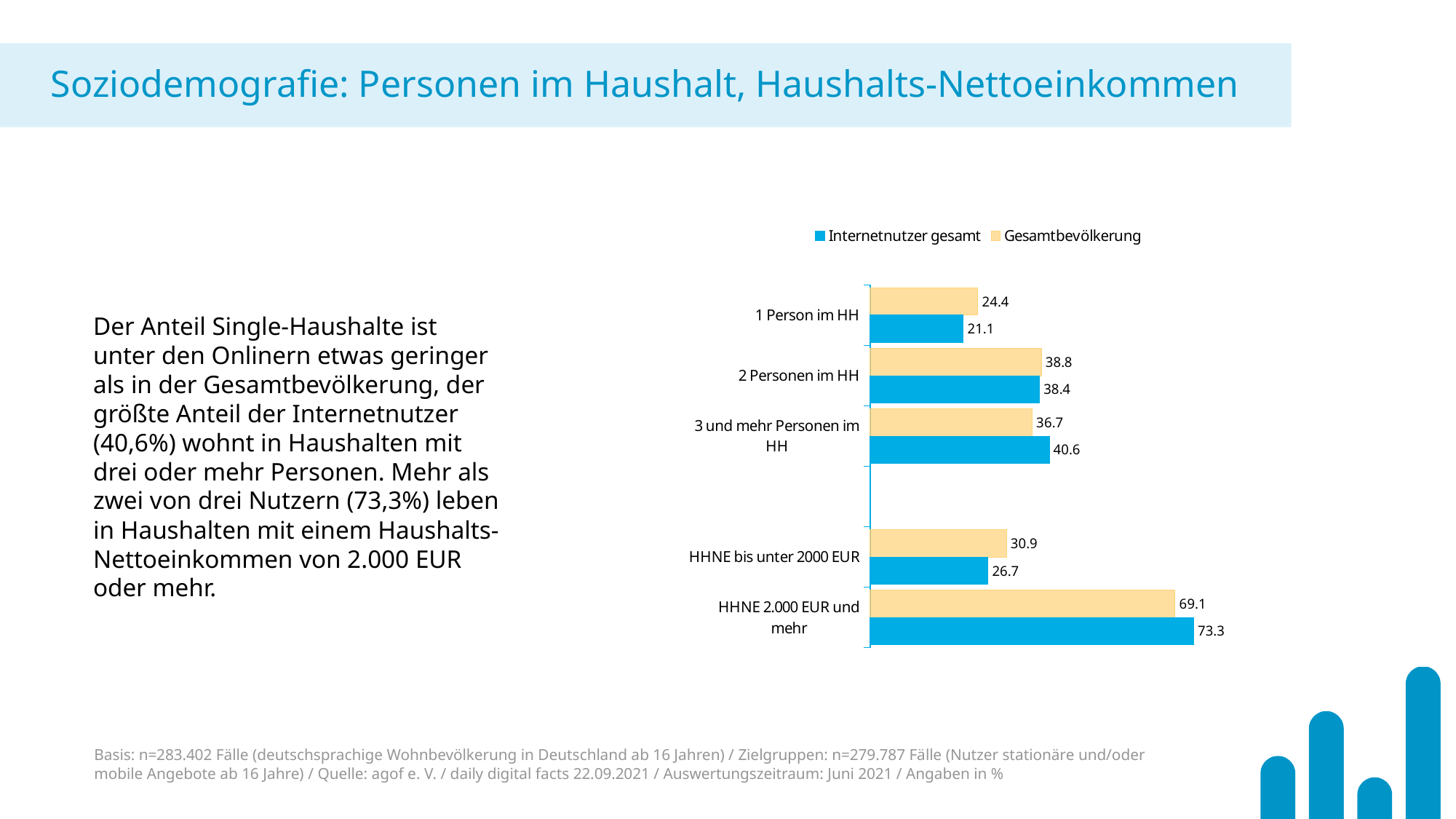
What is the value for Gesamtbevölkerung in the category '2 Personen im HH'? 38.8 In the category 'HHNE bis unter 2000 EUR', which series has the larger value, Internetnutzer gesamt or Gesamtbevölkerung? Gesamtbevölkerung What is the value for Internetnutzer gesamt in the category '1 Person im HH'? 21.1 Which category has the lowest value for Gesamtbevölkerung? 1 Person im HH What is the difference between Internetnutzer gesamt and Gesamtbevölkerung in the category '3 und mehr Personen im HH'? 3.9 What is the value for Gesamtbevölkerung in the category 'HHNE bis unter 2000 EUR'? 30.9 Which colour represents the series Gesamtbevölkerung in the chart? Yellow What is the value for Internetnutzer gesamt in the category 'HHNE 2.000 EUR und mehr'? 73.3 What kind of chart is shown on the slide? Bar chart Which category has the highest value for Internetnutzer gesamt? HHNE 2.000 EUR und mehr How many series does the legend list? 2 How many categories are shown in the chart? 5